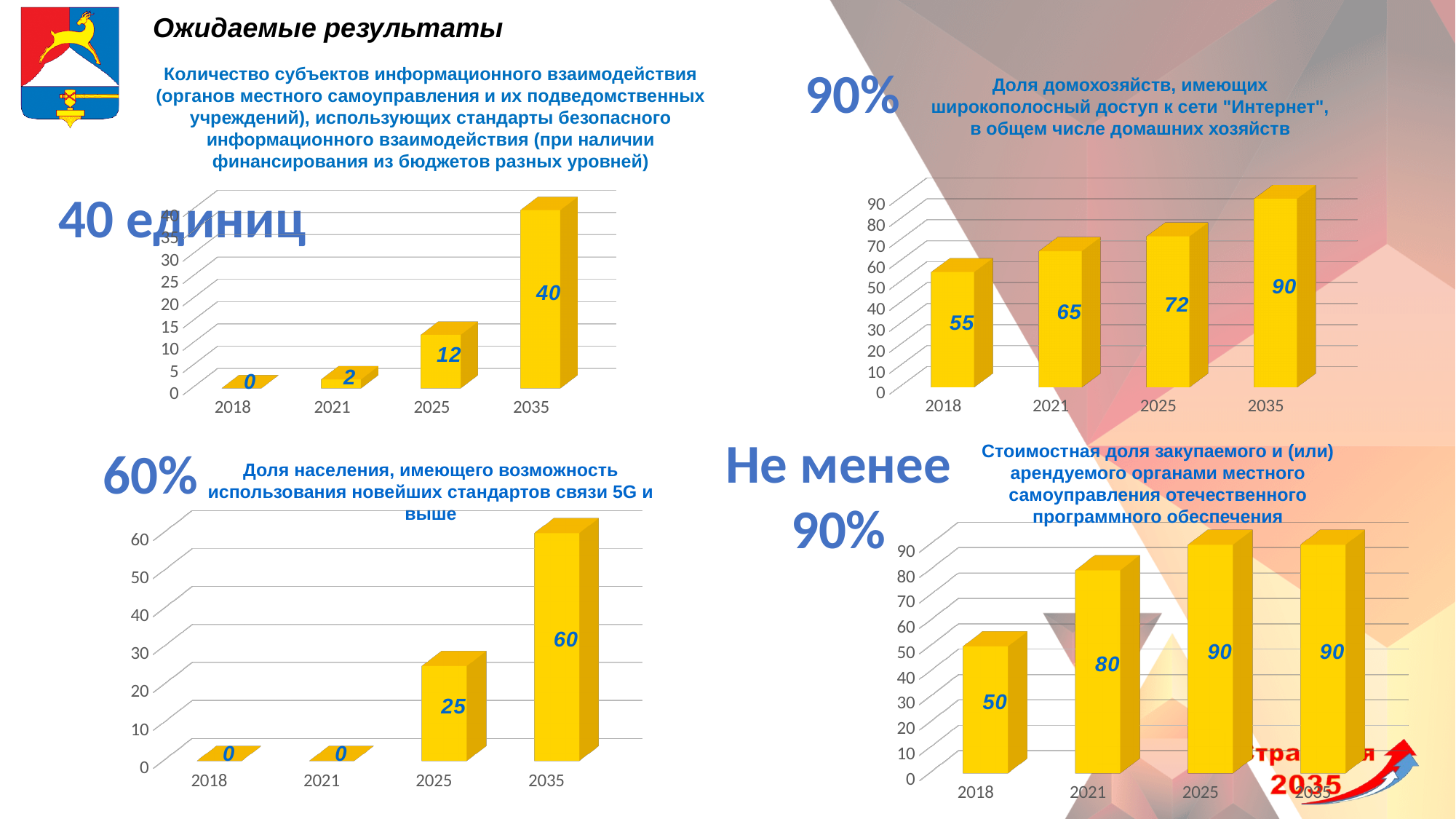
In the bottom-right chart, which is larger, the value for 2021 or the value for 2018? 2021 In the bottom-right chart, what is the value for 2018? 50 In the bottom-left chart, how many years are shown on the x axis? 4 In the top-right chart, do the values rise or fall from 2018 to 2035? rise In the top-left chart, which year has the highest value? 2035 In the top-right chart, what is the value for 2021? 65 In the top-right chart, which year has the lowest value? 2018 What type of chart is the bottom-right chart? bar chart In the bottom-left chart, what is the difference between the values for 2035 and 2025? 35 In the top-left chart, what is the value for 2025? 12 In the bottom-left chart, what is the value for 2035? 60 In the top-left chart, what is the difference between the values for 2035 and 2025? 28